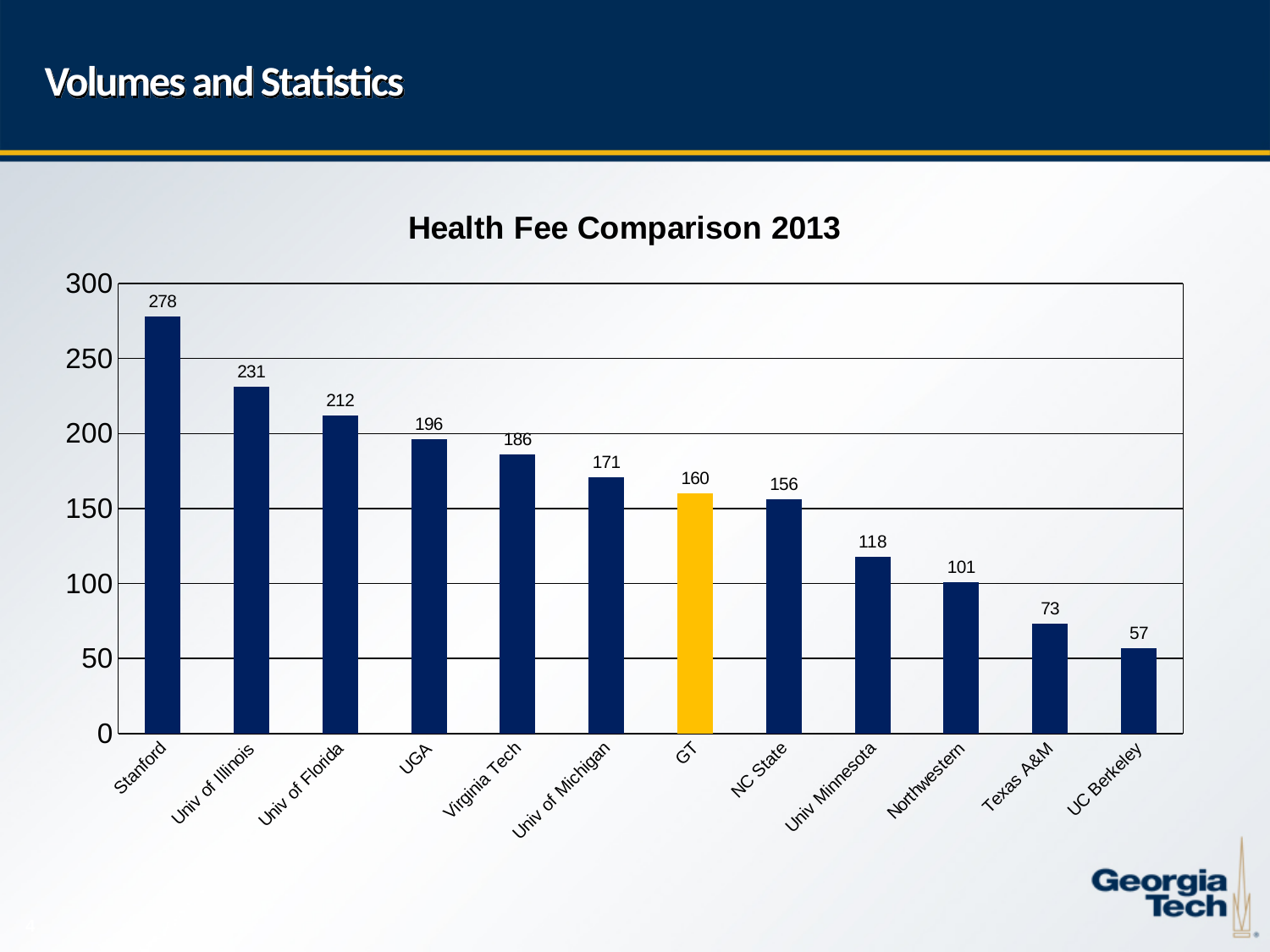
What is the value shown for GT? 160 How many institutions are shown in the chart? 12 What is the difference between the values for GT and NC State? 4 Is the value for Northwestern greater or less than 150? less What is the difference between the values for Stanford and UC Berkeley? 221 What kind of chart is shown on the slide? Bar chart Which institution has the lowest health fee in the chart? UC Berkeley Which institution has the highest health fee in the chart? Stanford What is the value shown for Univ Minnesota? 118 What is the health fee value shown for Stanford? 278 Which bar is highlighted in a different colour (gold) from the others? GT Which has a higher health fee, Univ of Florida or Virginia Tech? Univ of Florida